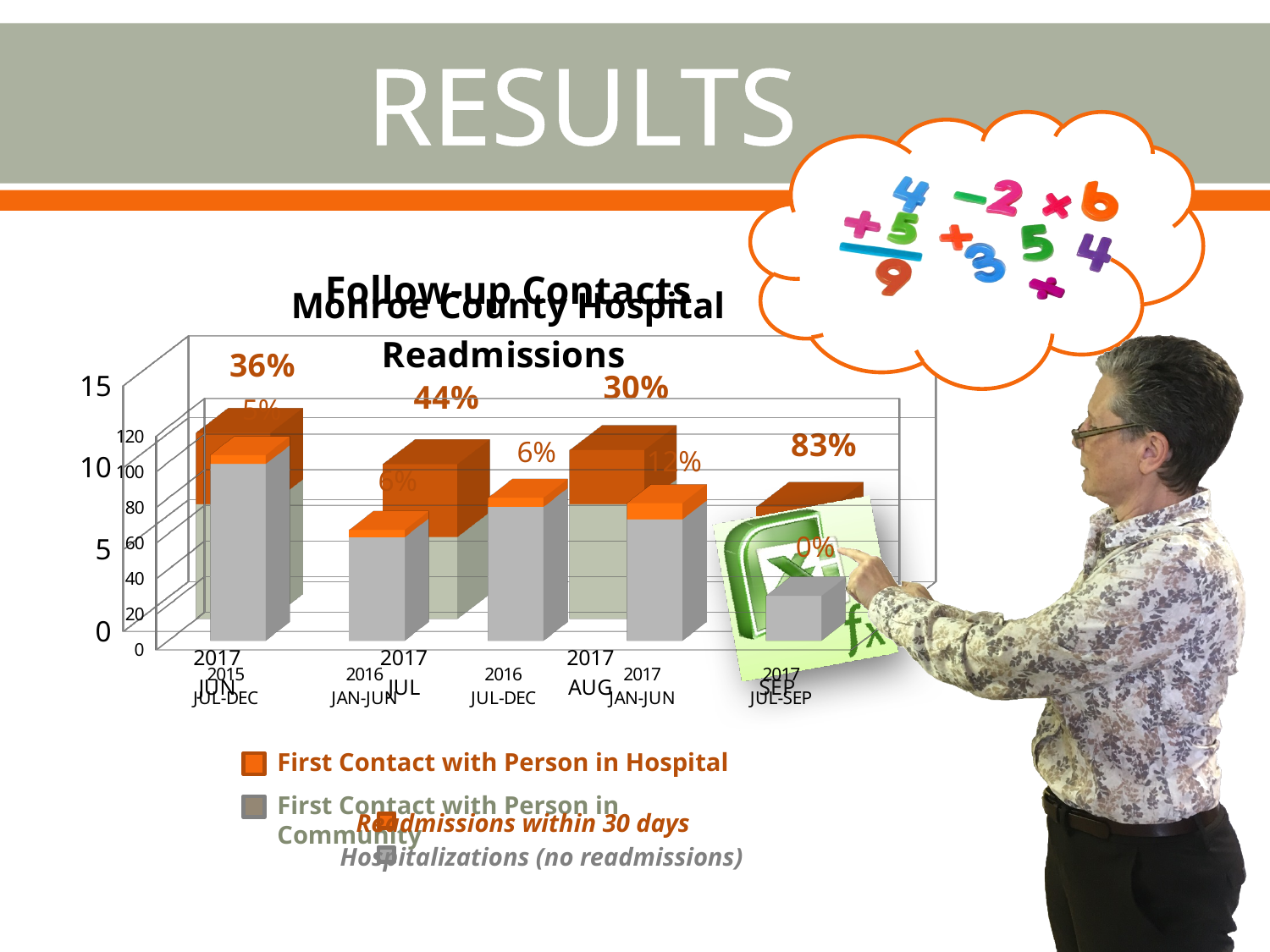
On the Monroe County Hospital Readmissions chart, how many periods are shown on the x axis? 5 On the Follow-up Contacts chart, what percentage is shown for 2017 SEP? 83% On the Follow-up Contacts chart, how many months are shown on the x axis? 4 On the Monroe County Hospital Readmissions chart, what percentage is shown for 2017 JUL-SEP? 0% On the Follow-up Contacts chart, what is the difference between the percentage labels for 2017 SEP and 2017 JUN? 47% On the Follow-up Contacts chart, what percentage is shown for 2017 JUL? 44% On the Follow-up Contacts chart, which month has the highest percentage label? 2017 SEP On the Monroe County Hospital Readmissions chart, what percentage is shown for 2017 JAN-JUN? 12% On the Follow-up Contacts chart, how many series does the legend list? 2 On the Monroe County Hospital Readmissions chart, which period has the highest readmission percentage label? 2017 JAN-JUN On the Follow-up Contacts chart, which legend entry is shown in orange? First Contact with Person in Hospital On the Follow-up Contacts chart, which month has the lowest percentage label? 2017 AUG